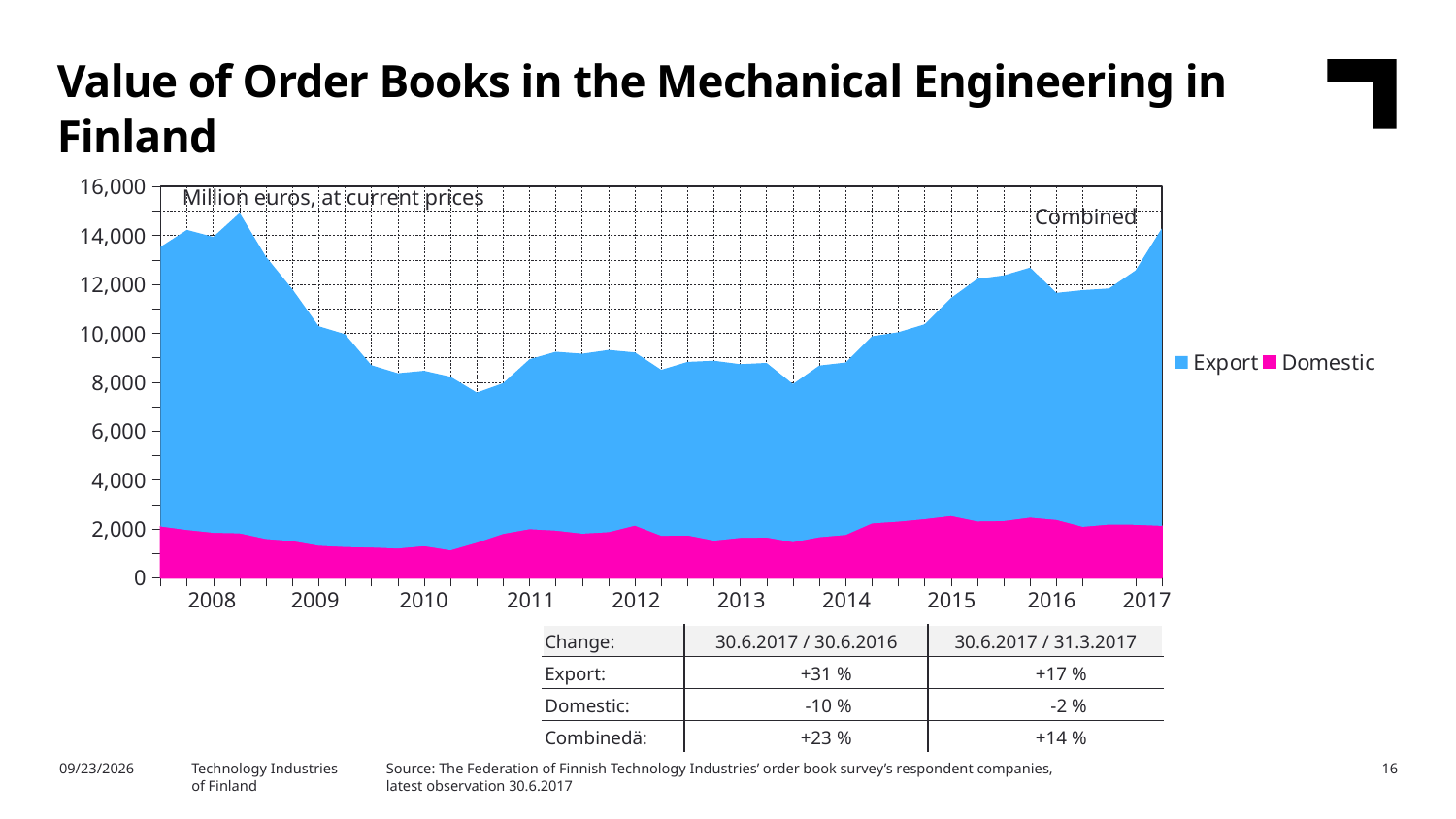
Which series accounts for the larger part of the combined order books, Export or Domestic? Export According to the table below the chart, what is the Export change for 30.6.2017 / 30.6.2016? +31 % Is the Domestic value of order books in 2010 greater or less than 2,000? less How many series does the chart's legend list? 2 Does the combined value of order books rise or fall between 2008 and 2010? fall What unit is stated in the label inside the chart area? Million euros, at current prices Is the combined value of order books higher in 2008 or in 2013? 2008 Is the combined value of order books in 2013 greater or less than 10,000? less What kind of chart is shown on the slide? Stacked area chart What are the two series named in the chart's legend? Export and Domestic Does the combined value of order books rise or fall between 2014 and 2016? rise Is the combined value of order books at the start of 2008 greater or less than 12,000? greater